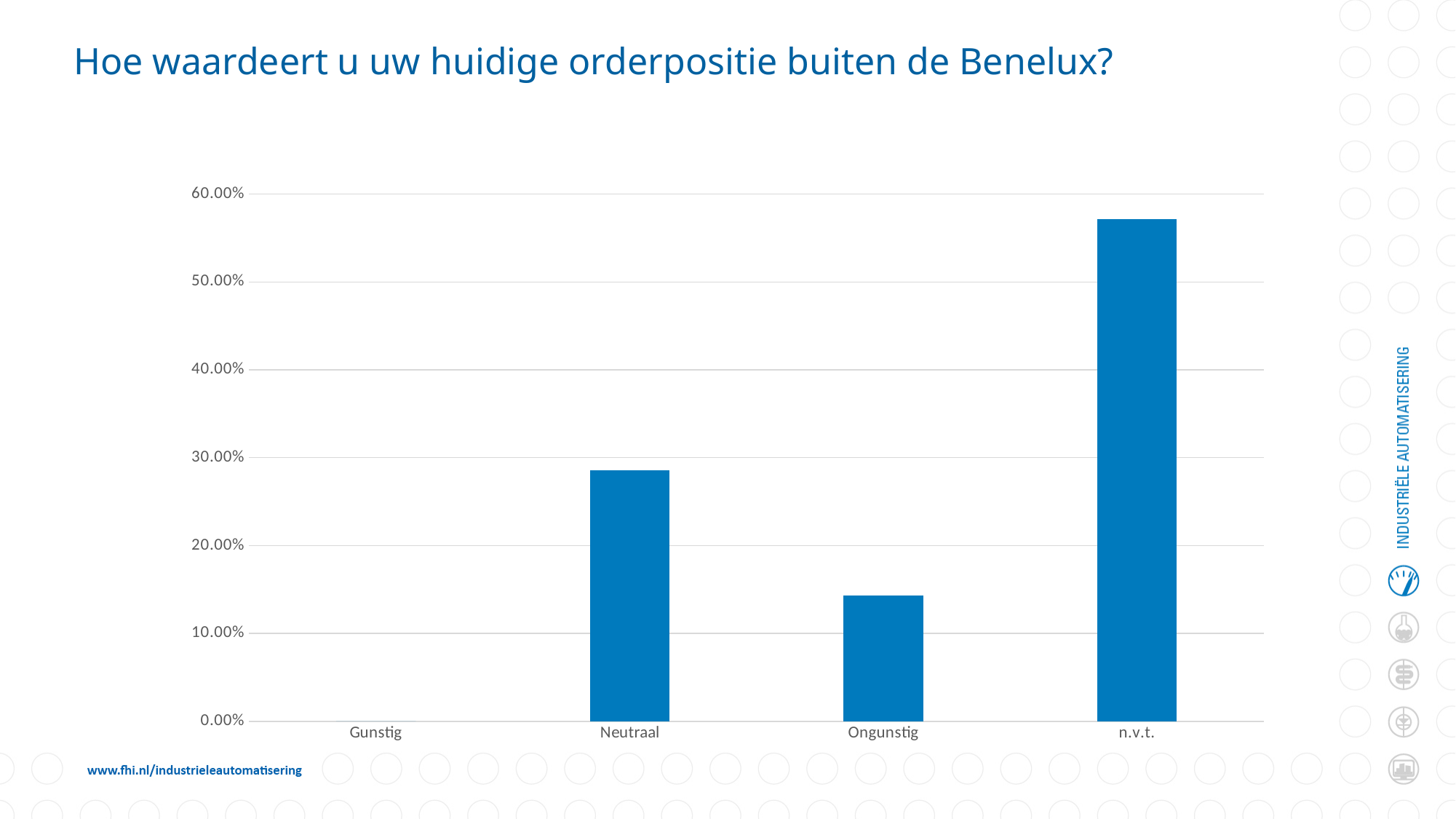
Is the value for Ongunstig greater or less than 10.00%? greater Which is larger, the value for n.v.t. or the value for Neutraal? n.v.t. How many categories are shown on the x axis of the chart? 4 Which category has the highest value in the chart? n.v.t. Which is larger, the value for Neutraal or the value for Ongunstig? Neutraal What kind of chart is shown on the slide? bar chart Is the value for Neutraal greater or less than 30.00%? less Which category has the lowest value in the chart? Gunstig What is the highest value shown on the y axis of the chart? 60.00% Is the value for Neutraal greater or less than 20.00%? greater What is the title of the slide containing the chart? Hoe waardeert u uw huidige orderpositie buiten de Benelux?